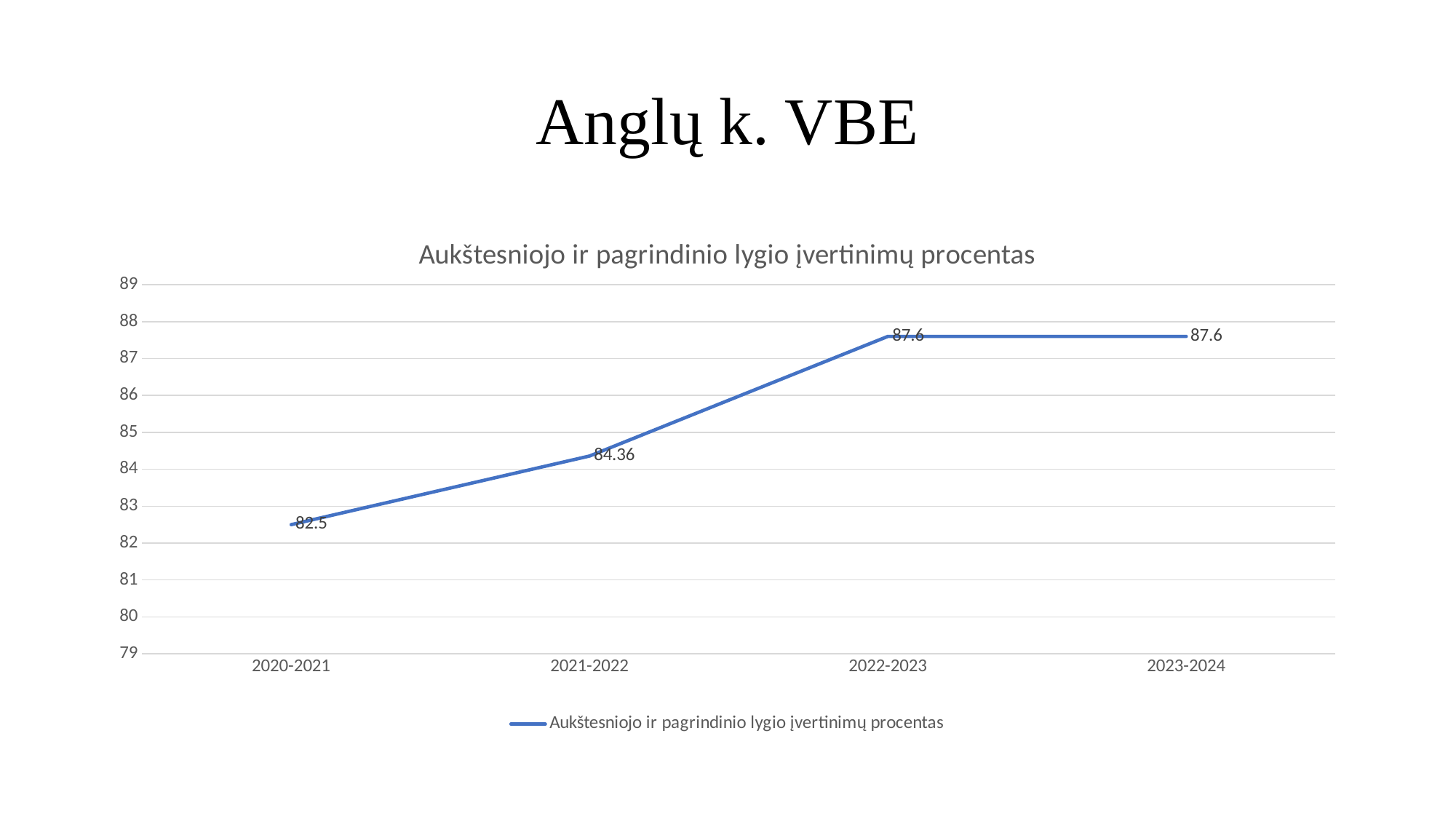
What is the value for 2022-2023? 87.6 Which is larger, the value for 2021-2022 or the value for 2022-2023? 2022-2023 What kind of chart is shown? line chart What is the title of the chart? Aukštesniojo ir pagrindinio lygio įvertinimų procentas How many periods are plotted on the x axis? 4 How many series does the legend list? 1 Is the value for 2021-2022 greater or less than 85? less What is the difference between the values for 2022-2023 and 2020-2021? 5.1 Which period has the lowest value? 2020-2021 What is the value for 2020-2021? 82.5 What is the value for 2021-2022? 84.36 What is the difference between the values for 2021-2022 and 2020-2021? 1.86